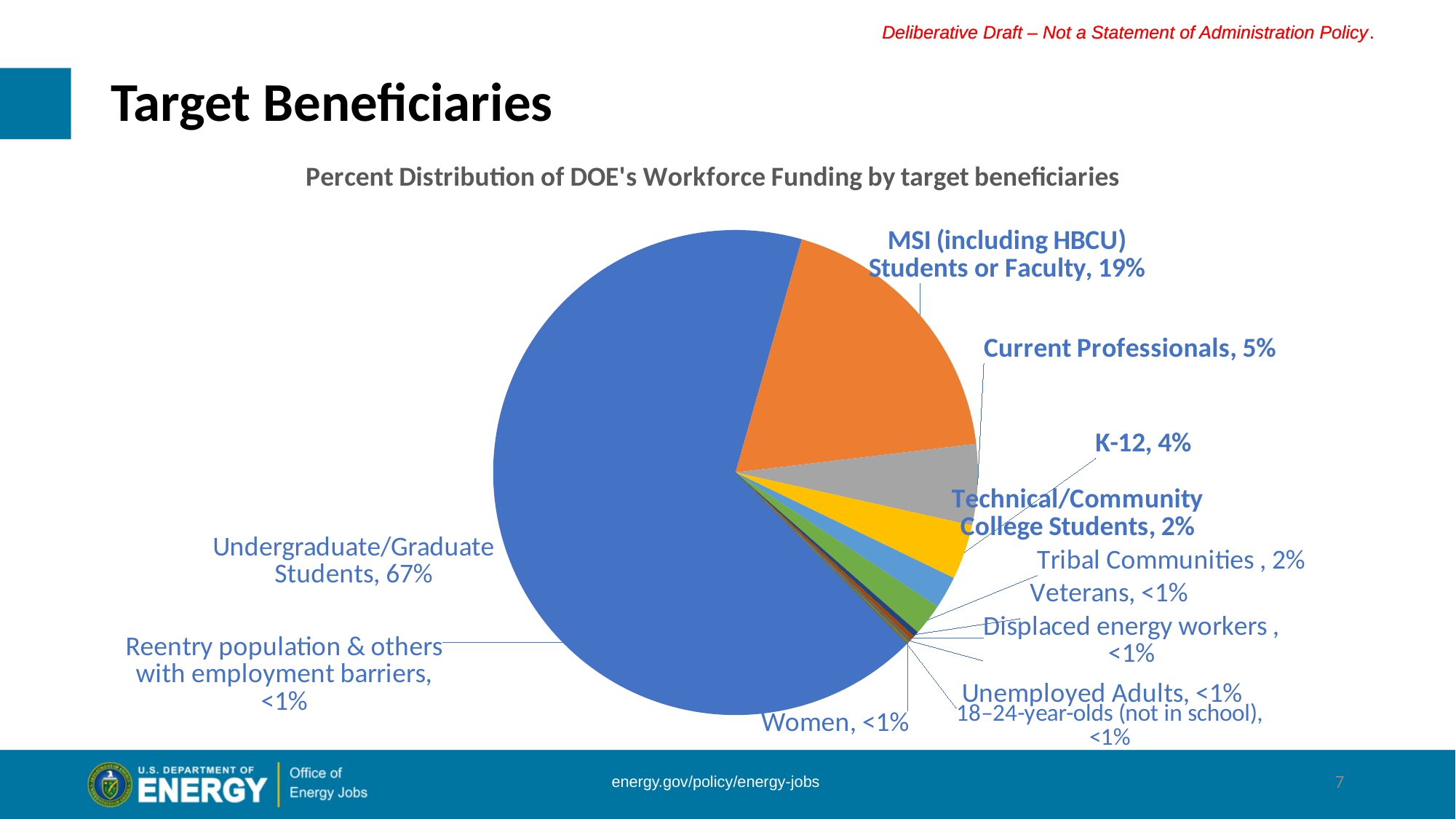
What percentage is shown for Veterans? <1% What is the title of the chart? Percent Distribution of DOE's Workforce Funding by target beneficiaries What percentage is shown for Current Professionals? 5% Which target beneficiary group receives the largest share of funding? Undergraduate/Graduate Students Which is larger, the share for Current Professionals or the share for K-12? Current Professionals What percentage is shown for Technical/Community College Students? 2% How many percentage points larger is the Undergraduate/Graduate Students share than the MSI (including HBCU) Students or Faculty share? 48 percentage points What percentage is shown for K-12? 4% What percentage is shown for MSI (including HBCU) Students or Faculty? 19% How many target beneficiary categories are shown in the pie chart? 12 What share of DOE's workforce funding goes to Undergraduate/Graduate Students? 67% What type of chart is shown on the slide? Pie chart